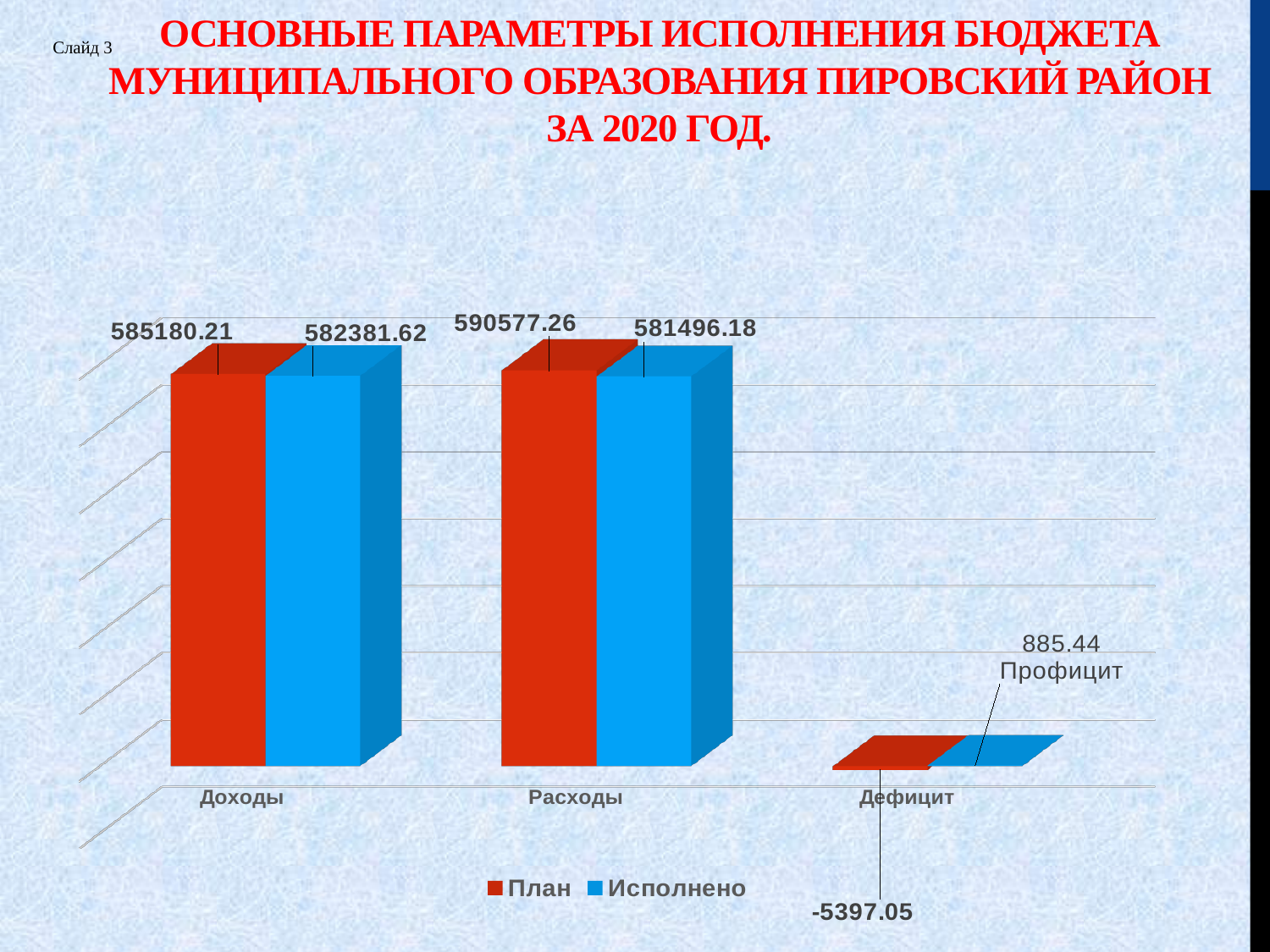
What is the План value for Дефицит? -5397.05 Which category has the highest План value? Расходы How many series does the legend list? 2 What type of chart is shown on the slide? bar chart How many categories are shown on the x axis? 3 Which is larger for Доходы: the План value or the Исполнено value? План What is the difference between the План and Исполнено values for Расходы? 9081.08 What is the План value for Доходы? 585180.21 What is the Исполнено value for Дефицит? 885.44 What is the Исполнено value for Расходы? 581496.18 What is the План value for Расходы? 590577.26 What is the Исполнено value for Доходы? 582381.62